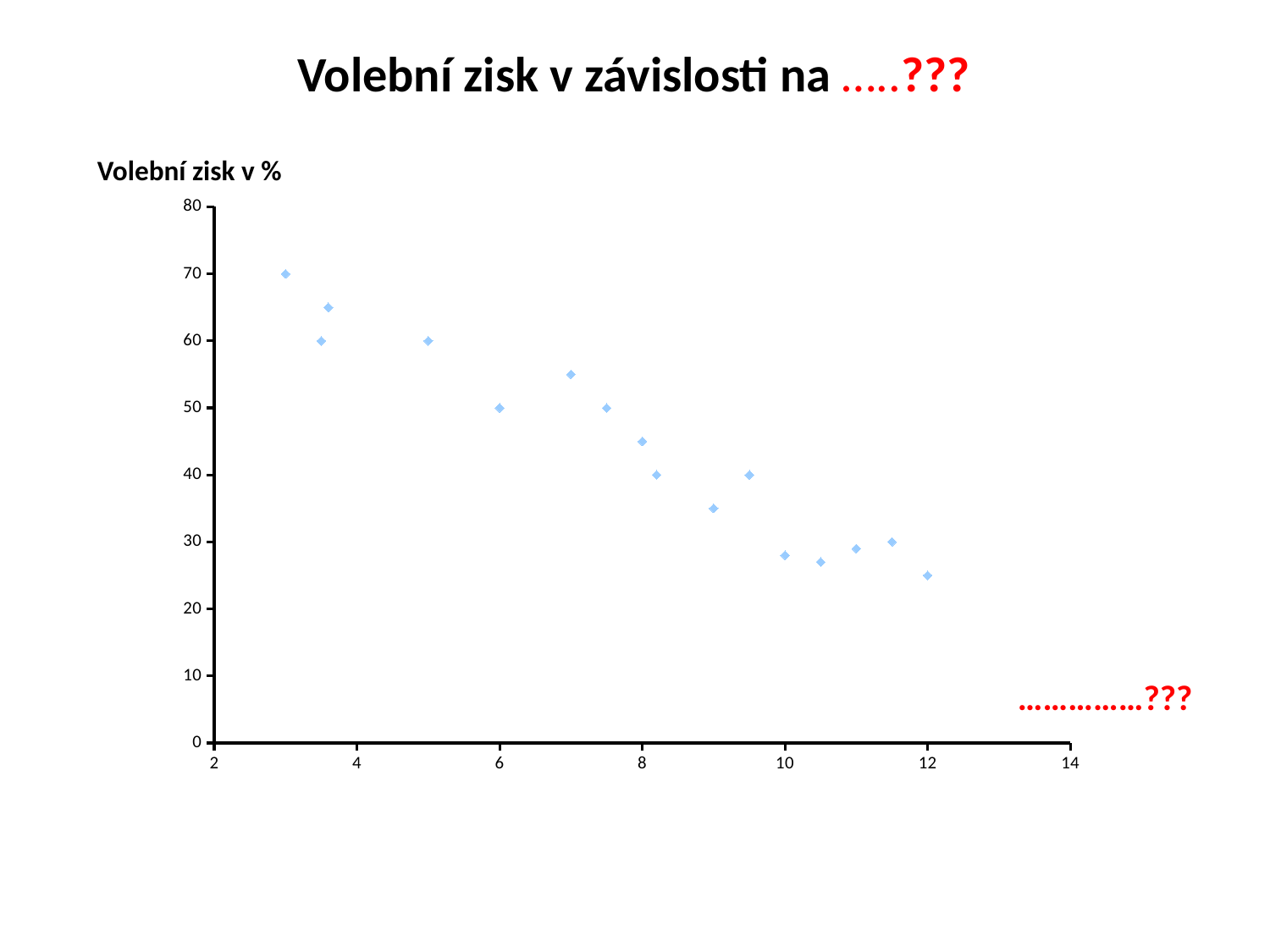
Is the value for the point at x = 7 greater or less than 50? greater What is the label of the vertical axis? Volební zisk v % Is the value for the point at x = 9 greater or less than 30? greater How many data points are plotted on the chart? 16 At which x value is the highest plotted point? 3 What is the y value of the point at x = 3? 70 What is the y value of the point at x = 5? 60 Which point has the larger y value, the one at x = 3 or the one at x = 12? x = 3 What is the y value of the point at x = 6? 50 Is the value for the point at x = 12 greater or less than 30? less Do the plotted values generally rise or fall as the x value increases? fall What kind of chart is shown on the slide? scatter chart